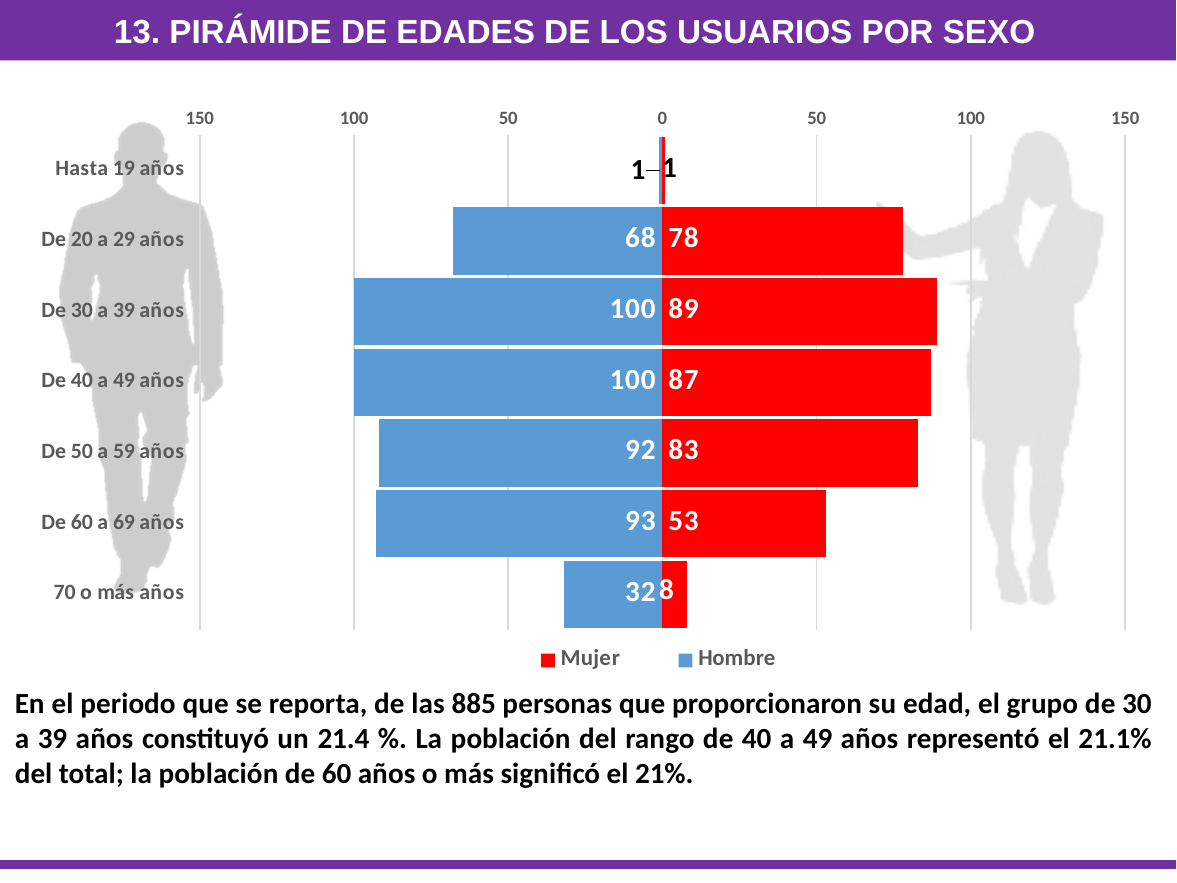
What is the Hombre value for the 'De 20 a 29 años' age group? 68 How many age groups are shown on the chart? 7 What kind of chart is shown on the slide? Bar chart What is the Mujer value for the '70 o más años' age group? 8 What is the difference between the Hombre and Mujer values for the 'De 60 a 69 años' age group? 40 Which colour represents the Mujer series in the chart? Red What is the Mujer value for the 'De 60 a 69 años' age group? 53 What is the total of the Hombre and Mujer values for the 'De 50 a 59 años' age group? 175 How many series does the legend list? 2 For the 'De 20 a 29 años' age group, which is larger, the Mujer value or the Hombre value? Mujer Which age group has the highest Mujer value? De 30 a 39 años Which age group has the lowest Hombre value? Hasta 19 años